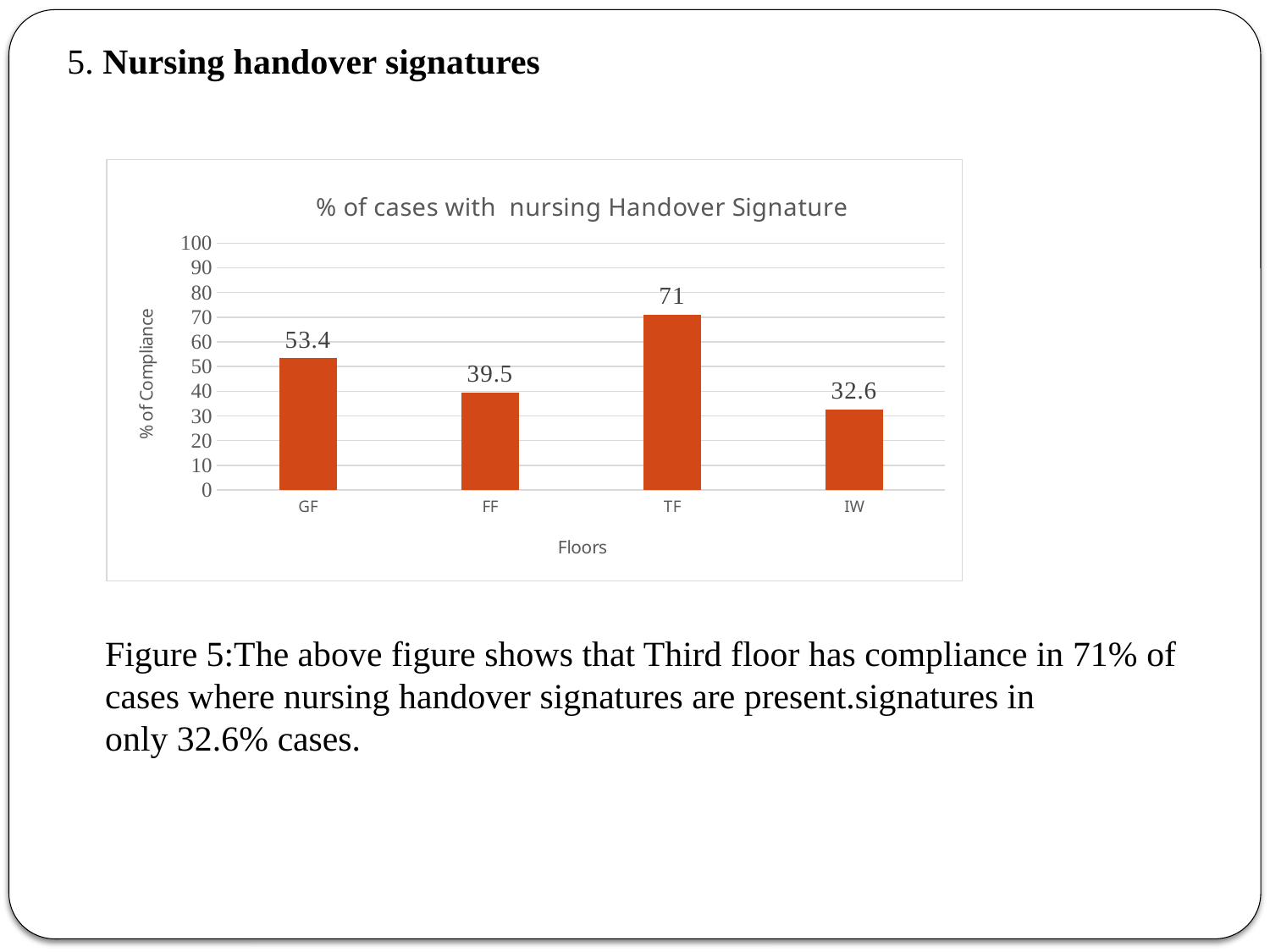
Which is larger, the value for GF or the value for FF? GF What is the value for TF? 71 How many floors are shown on the x axis? 4 What kind of chart is this? bar chart What is the value for IW? 32.6 What is the value for FF? 39.5 What is the difference between the values for TF and IW? 38.4 Which floor has the highest % of compliance? TF Which floor has the lowest % of compliance? IW What is the value for GF? 53.4 What is the title of the chart? % of cases with nursing Handover Signature What is the difference between the values for GF and FF? 13.9